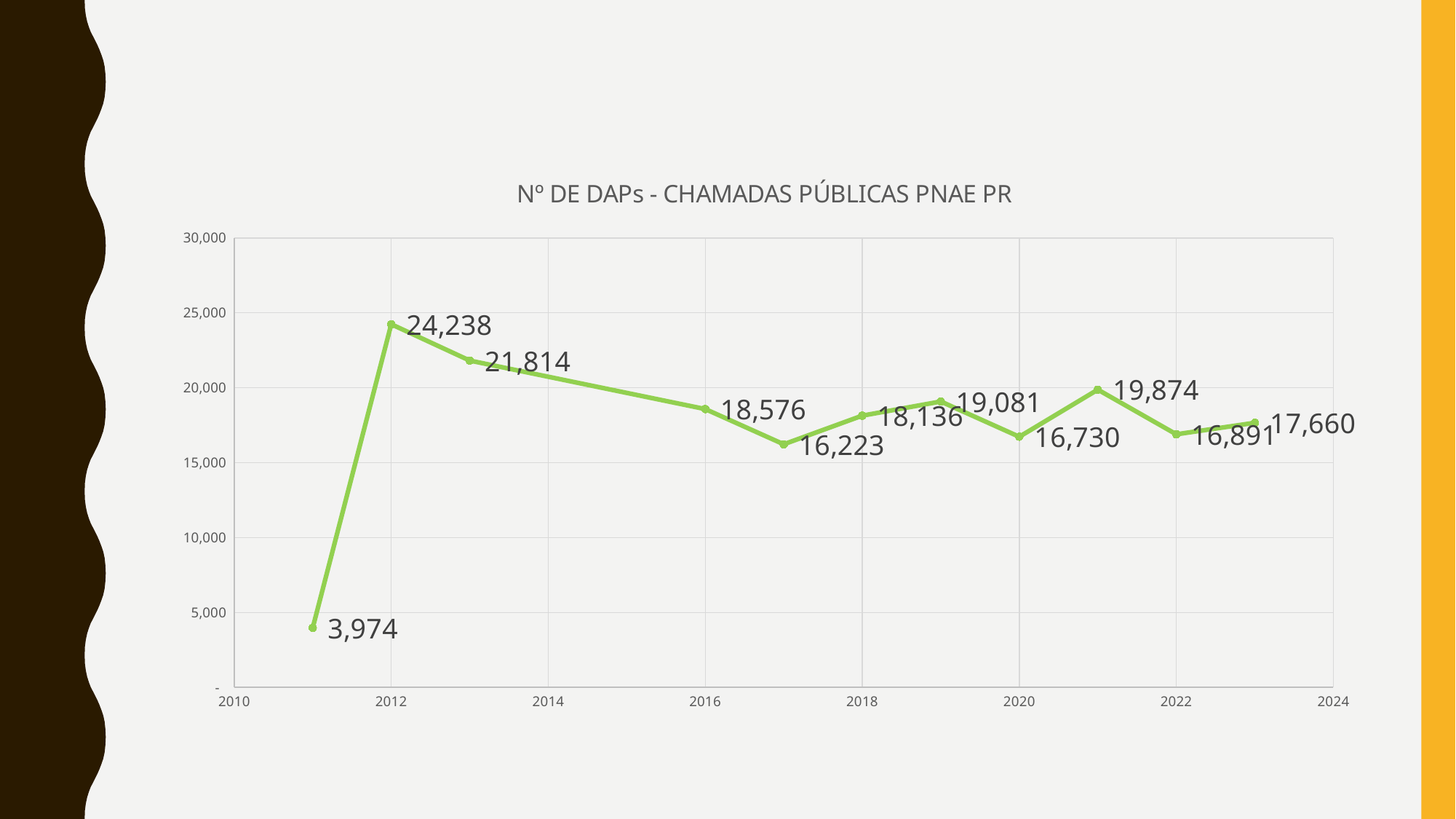
Which is larger, the value for 2019 or the value for 2018? 2019 What is the value plotted for 2012? 24,238 How many data points are plotted on the line? 11 Which year has the highest value? 2012 Do the values rise or fall from 2012 to 2017? Fall What is the difference between the values for 2012 and 2013? 2,424 What is the difference between the values for 2021 and 2020? 3,144 What is the value plotted for 2017? 16,223 What type of chart is shown on the slide? Line chart What is the title of the chart? Nº DE DAPs - CHAMADAS PÚBLICAS PNAE PR What is the value plotted for 2023? 17,660 Which year has the lowest value? 2011